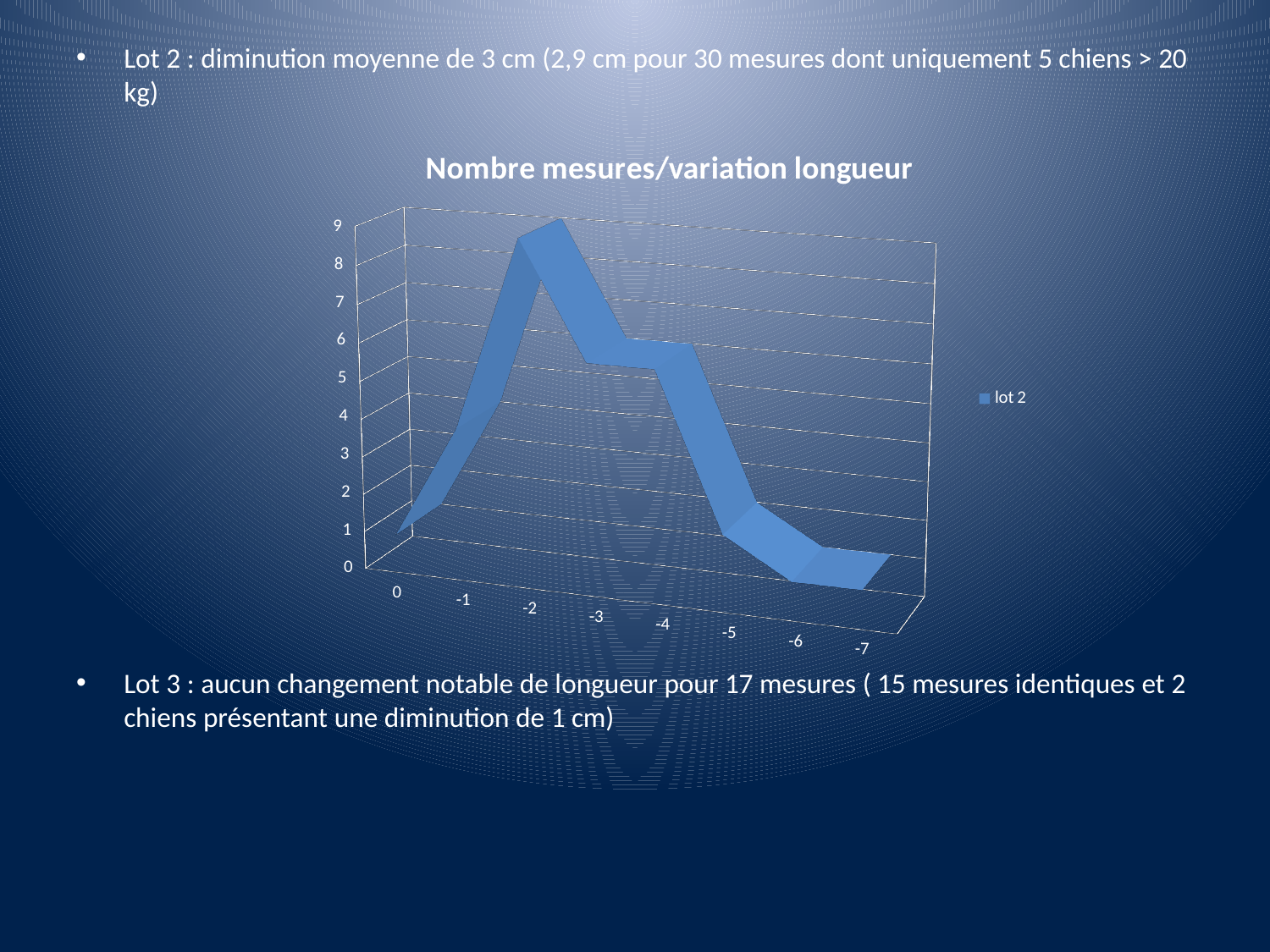
Which has the larger value, -2 or -5? -2 Do the values rise or fall along the x axis from -2 to -7? fall What is the name of the series shown in the legend? lot 2 How many categories are shown along the x axis of the chart? 8 Is the value for -5 greater or less than 4? less Is the value for -1 greater or less than 6? less Which has the larger value, -3 or -6? -3 What kind of chart is shown on the slide? line chart Which x-axis category has the highest value in the chart? -2 Is the value for -2 greater or less than 6? greater What is the title of the chart? Nombre mesures/variation longueur How many series does the chart legend list? 1